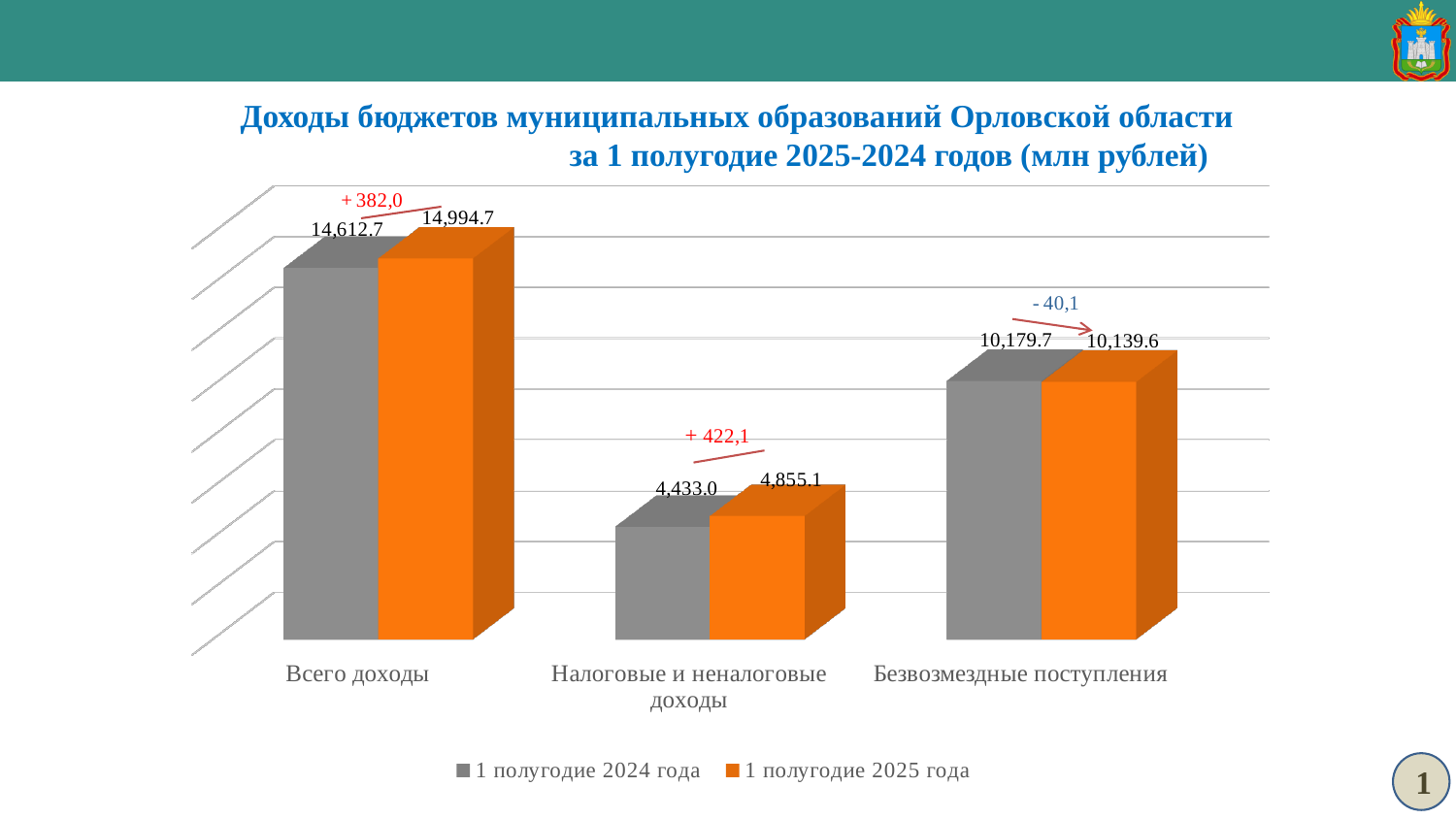
What is the value for Всего доходы in 1 полугодие 2025 года? 14,994.7 How many categories are shown on the x axis? 3 For Безвозмездные поступления, which is larger: the 1 полугодие 2024 года value or the 1 полугодие 2025 года value? 1 полугодие 2024 года What is the value for Безвозмездные поступления in 1 полугодие 2025 года? 10,139.6 Which category has the highest value in 1 полугодие 2024 года? Всего доходы What is the difference between the 1 полугодие 2025 года and 1 полугодие 2024 года values for Налоговые и неналоговые доходы? 422.1 What kind of chart is shown on the slide? Bar chart What is the value for Налоговые и неналоговые доходы in 1 полугодие 2024 года? 4,433.0 Which category has the lowest value in 1 полугодие 2025 года? Налоговые и неналоговые доходы What is the difference between the 1 полугодие 2025 года and 1 полугодие 2024 года values for Всего доходы? 382.0 How many series does the legend list? 2 What is the value for Безвозмездные поступления in 1 полугодие 2024 года? 10,179.7